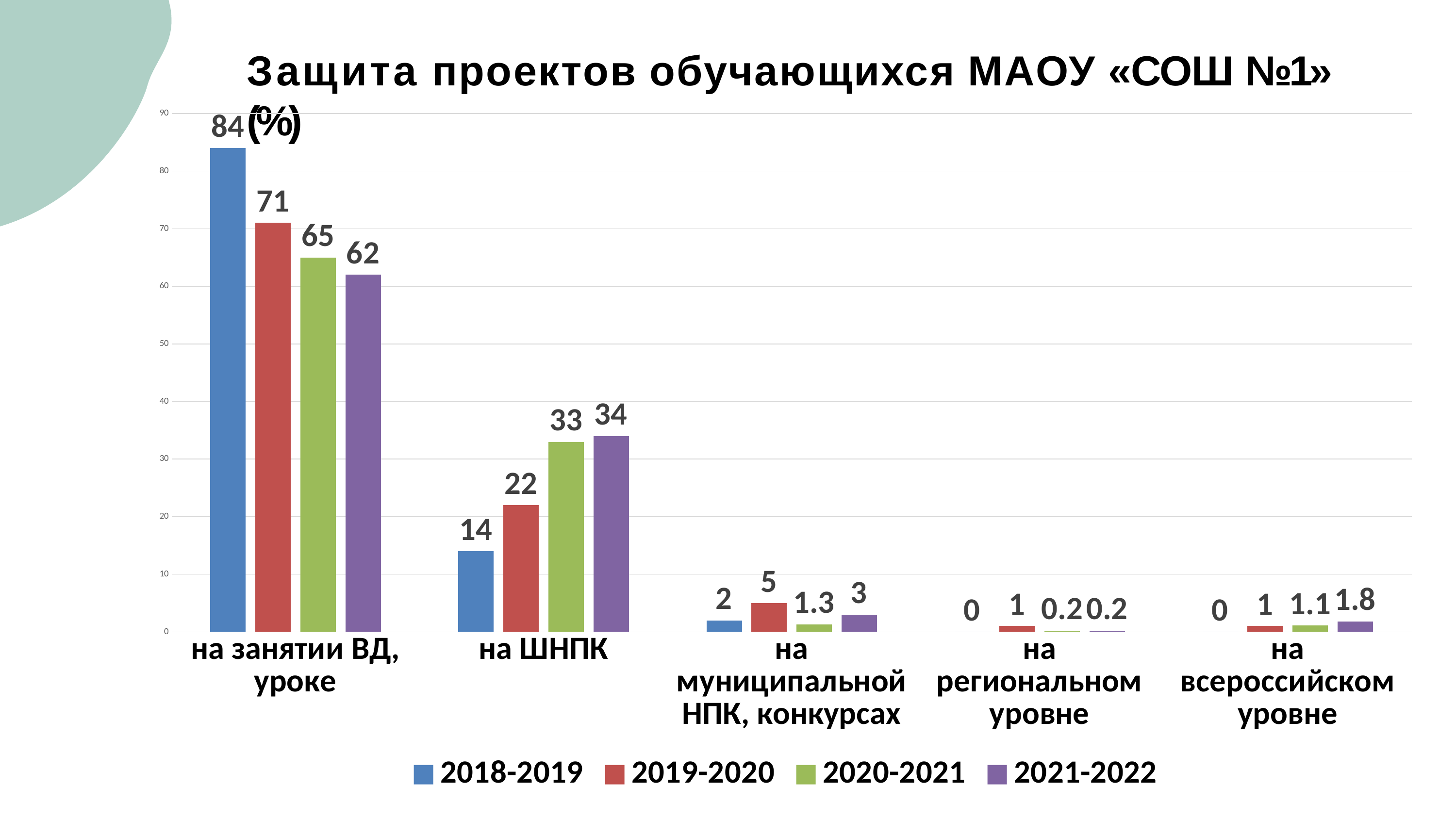
What is the value for 2019-2020 in the category "на муниципальной НПК, конкурсах"? 5 What is the value for 2018-2019 in the category "на занятии ВД, уроке"? 84 Which series has the highest value in the category "на занятии ВД, уроке"? 2018-2019 How many categories are shown on the x axis? 5 What type of chart is shown on the slide? bar chart What is the value for 2021-2022 in the category "на ШНПК"? 34 Which is larger in the category "на ШНПК": the value for 2019-2020 or the value for 2020-2021? 2020-2021 Do the values for the 2018-2019 series rise or fall across the categories from left to right? fall What is the difference between the 2018-2019 and 2021-2022 values in the category "на занятии ВД, уроке"? 22 What is the value for 2021-2022 in the category "на всероссийском уровне"? 1.8 Which series has the lowest value in the category "на ШНПК"? 2018-2019 How many series does the legend list? 4